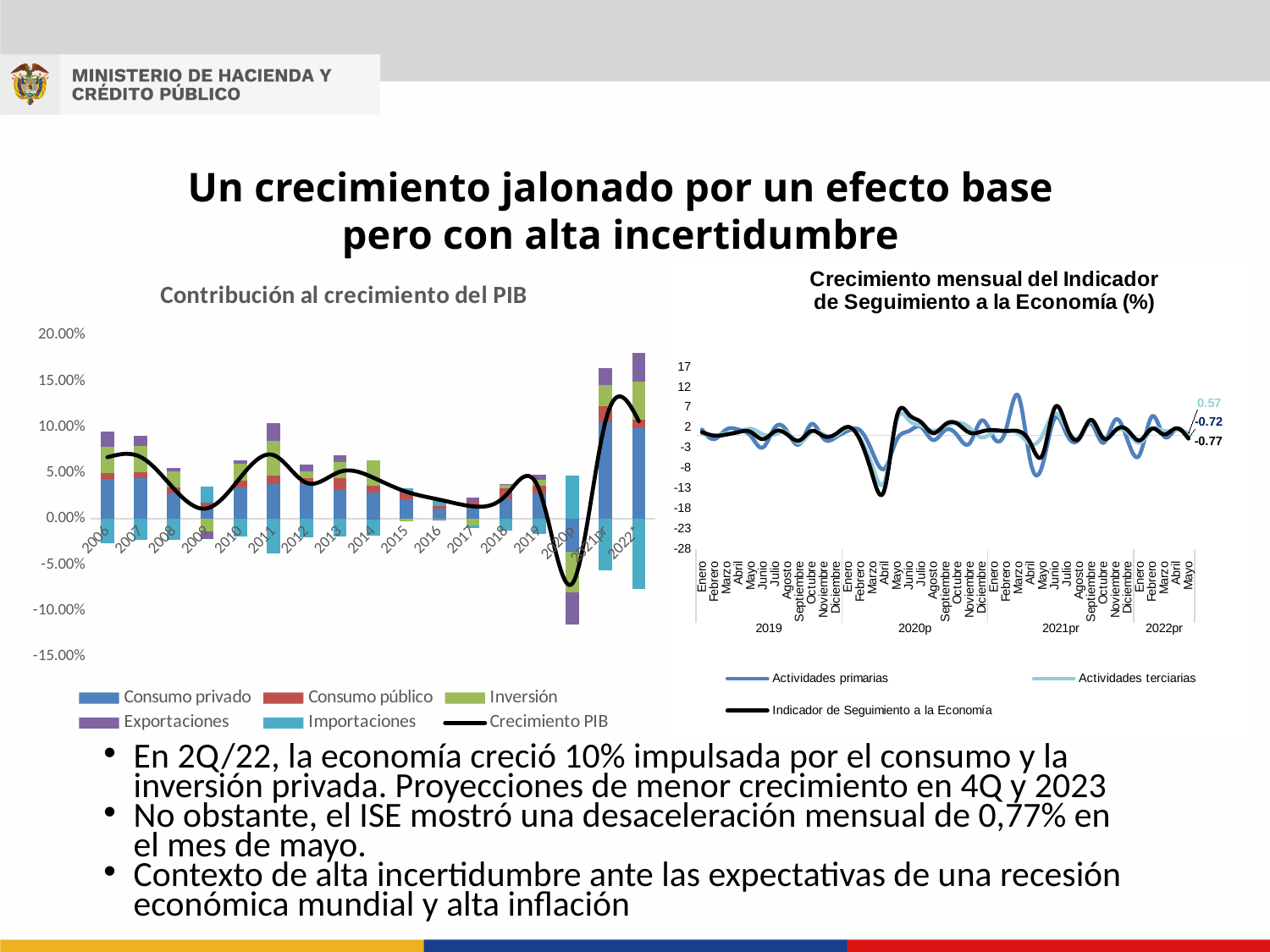
In the 'Crecimiento mensual del Indicador de Seguimiento a la Economía (%)' chart, what is the difference between the final labelled values of Actividades terciarias (0.57) and Actividades primarias (-0.72)? 1.29 In the 'Contribución al crecimiento del PIB' chart, is the Crecimiento PIB line for 2020p greater or less than -5.00%? less How many series does the legend of the 'Crecimiento mensual del Indicador de Seguimiento a la Economía (%)' chart list? 3 In the 'Crecimiento mensual del Indicador de Seguimiento a la Economía (%)' chart, what is the last labelled value for Actividades primarias? -0.72 What kind of chart is the 'Contribución al crecimiento del PIB' chart on the left? bar chart with a line In the 'Crecimiento mensual del Indicador de Seguimiento a la Economía (%)' chart, what is the last labelled value for the Indicador de Seguimiento a la Economía? -0.77 How many years (categories) are shown on the x axis of the 'Contribución al crecimiento del PIB' chart? 17 In the 'Crecimiento mensual del Indicador de Seguimiento a la Economía (%)' chart, what is the last labelled value for Actividades terciarias? 0.57 In the 'Contribución al crecimiento del PIB' chart, does the Crecimiento PIB line rise or fall from 2020p to 2021pr? rise How many series does the legend of the 'Contribución al crecimiento del PIB' chart list? 6 In the 'Crecimiento mensual del Indicador de Seguimiento a la Economía (%)' chart, which has the higher final labelled value, Actividades primarias or Actividades terciarias? Actividades terciarias In the 'Crecimiento mensual del Indicador de Seguimiento a la Economía (%)' chart, in which year section does the Indicador de Seguimiento a la Economía line reach its lowest point? 2020p